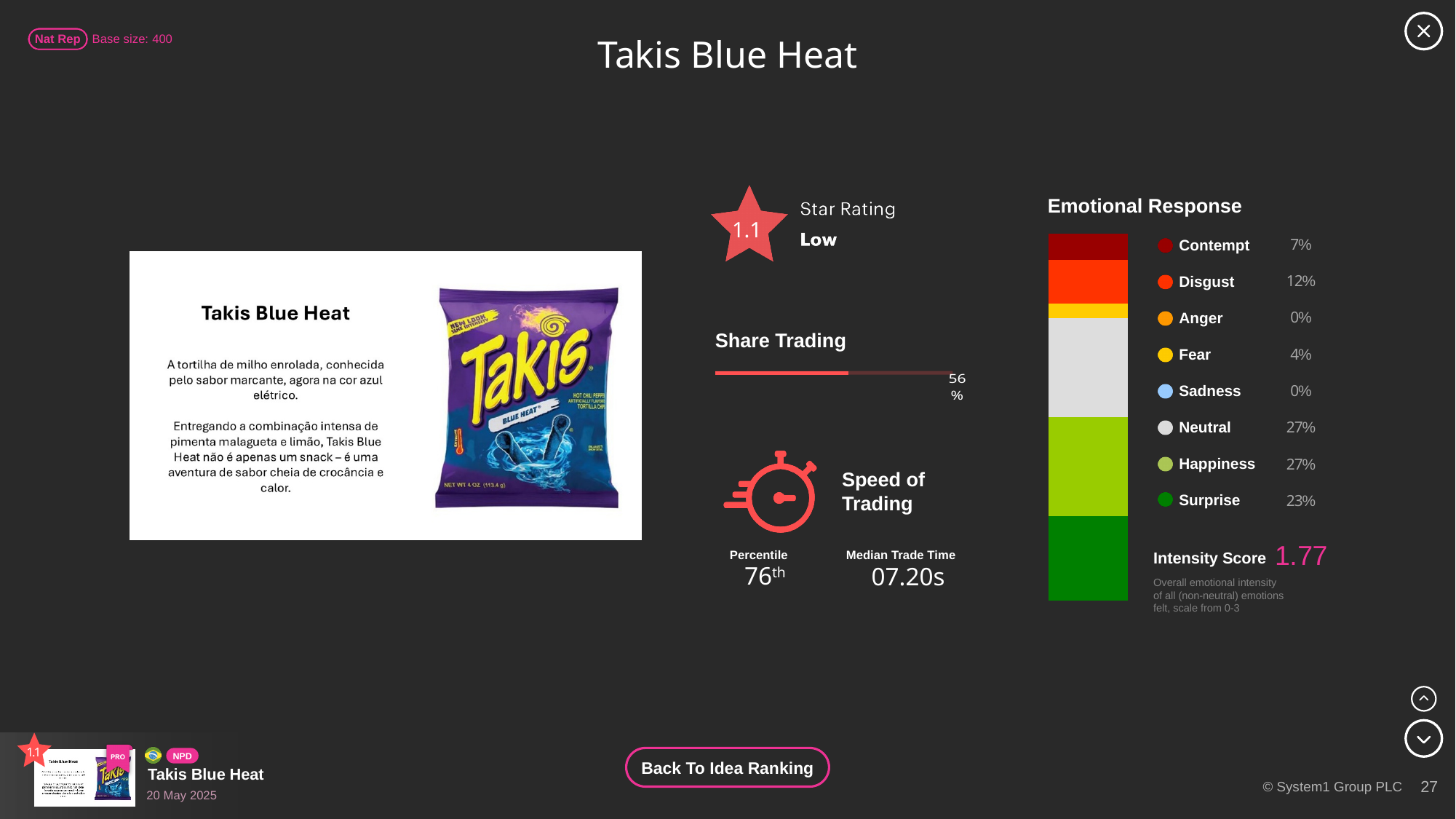
In the Emotional Response chart, what percentage is shown for Neutral? 27% In the Emotional Response chart, what percentage is shown for Fear? 4% In the Emotional Response chart, which two emotions have a value of 0%? Anger and Sadness How many emotions are listed in the Emotional Response chart? 8 In the Emotional Response chart, what is the difference between Disgust and Contempt? 5% What value is shown on the Share Trading bar? 56% What kind of chart is the Emotional Response chart? Stacked bar chart In the Emotional Response chart, which is larger, Surprise or Contempt? Surprise In the Emotional Response chart, what percentage is shown for Surprise? 23% In the Emotional Response chart, what is the difference between Happiness and Surprise? 4% In the Emotional Response chart, what percentage is shown for Disgust? 12% What is the Intensity Score shown below the Emotional Response chart? 1.77